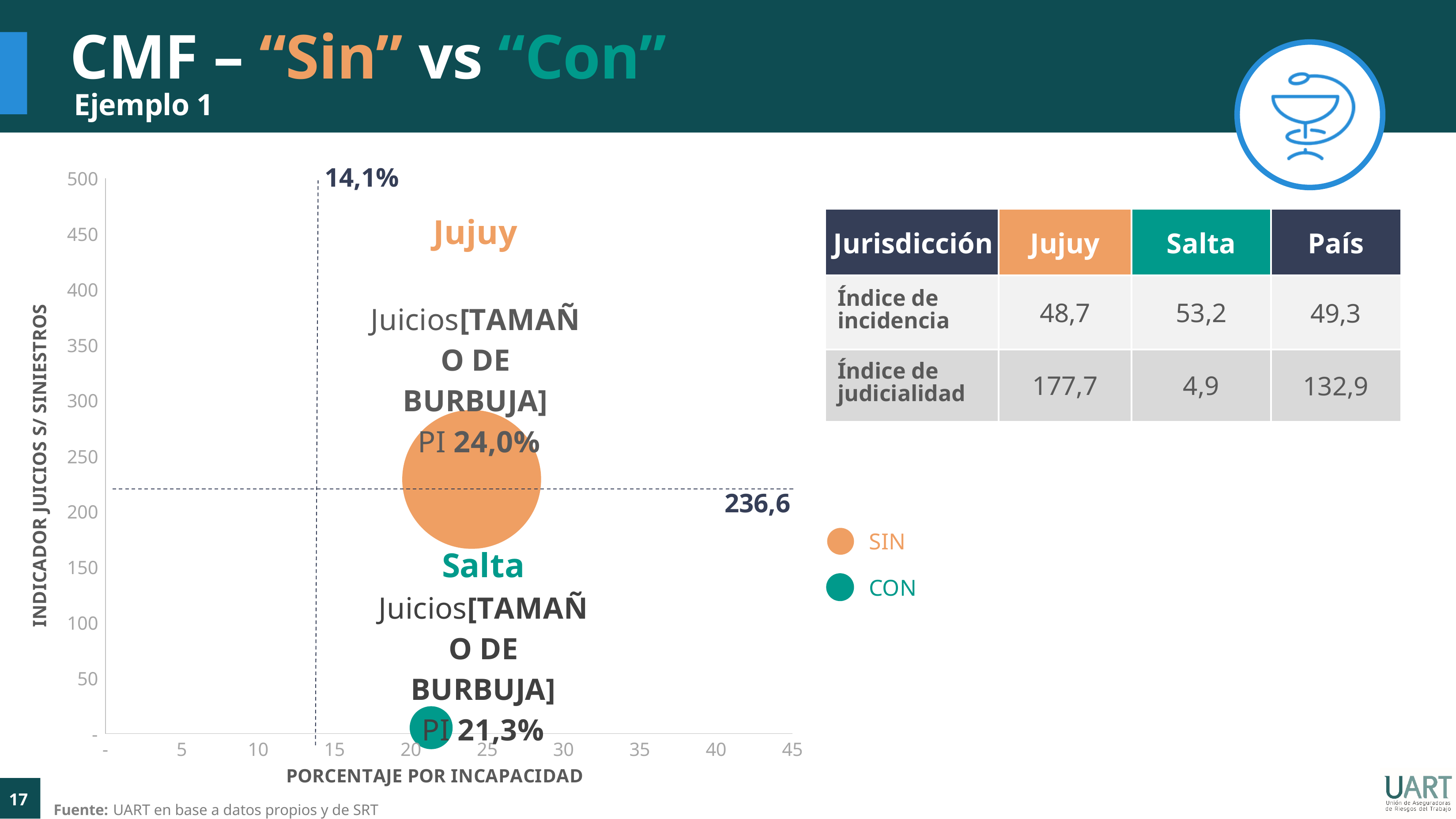
What is the PI value printed for the Salta bubble? 21,3% Which bubble sits higher on the 'Indicador juicios s/ siniestros' axis, Jujuy or Salta? Jujuy What value is labelled on the vertical dashed reference line of the chart? 14,1% How many series does the legend of the bubble chart list? 2 What is the difference between the PI values printed for Jujuy and Salta? 2,7 percentage points What value is labelled on the horizontal dashed reference line of the chart? 236,6 What is the PI value printed for the Jujuy bubble? 24,0% What are the two entries in the chart's legend? SIN and CON What kind of chart is shown on the left of the slide? bubble chart How many bubbles are plotted on the chart? 2 Is the Jujuy bubble's value on the vertical axis greater or less than 100? greater Is the Salta bubble's value on the vertical axis greater or less than 50? less